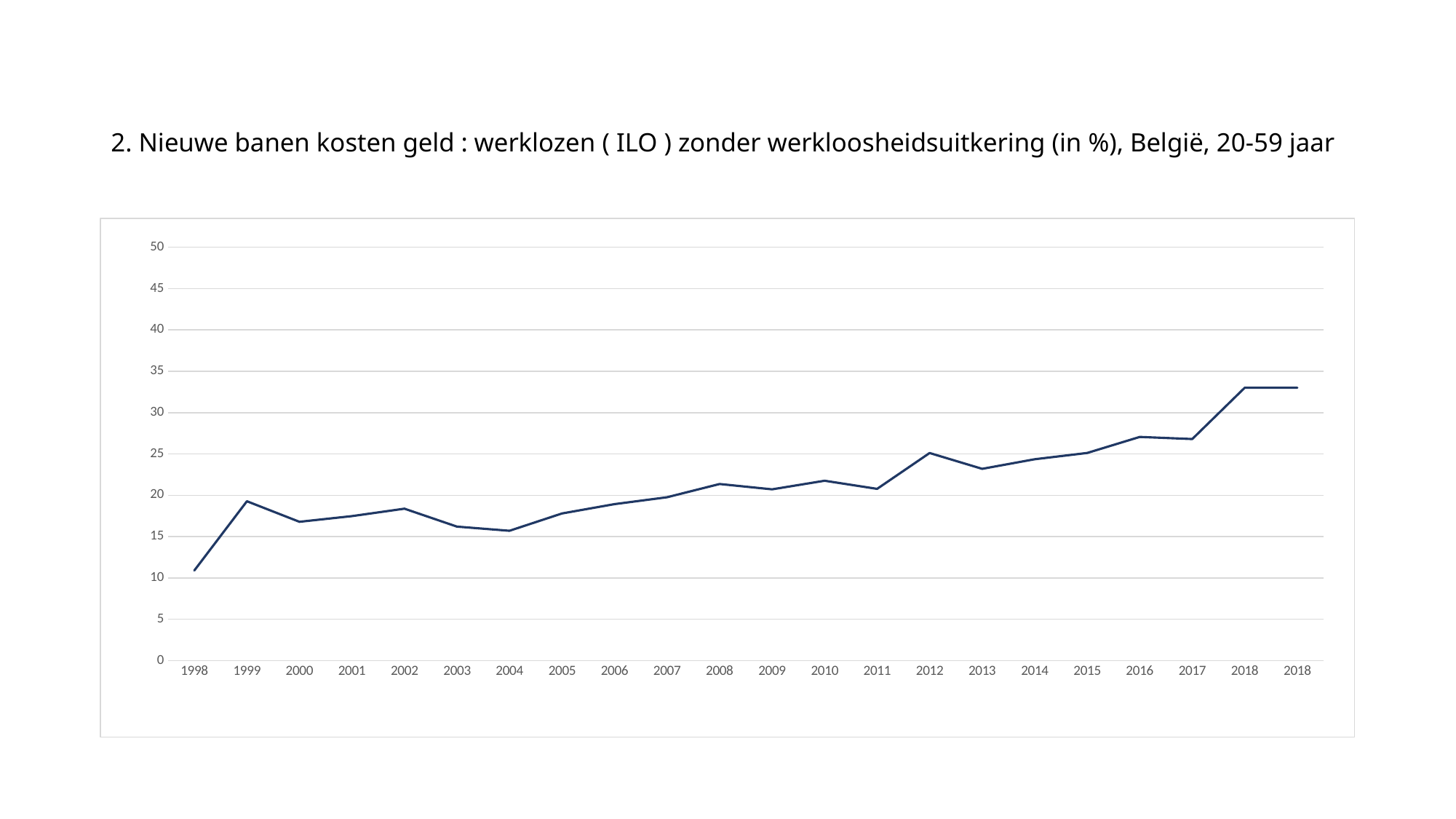
Which year has the larger value, 2017 or 2018? 2018 What is the highest value shown on the vertical axis? 50 Is the value for 2012 greater or less than 20? greater Which year has the lowest value on the chart? 1998 What kind of chart is shown on the slide? line chart Is the value for 2016 greater or less than 25? greater Overall, do the values rise or fall from 1998 to 2018? rise Which year has the larger value, 1999 or 2000? 1999 Is the value for 2004 greater or less than 20? less Which year has the highest value on the chart? 2018